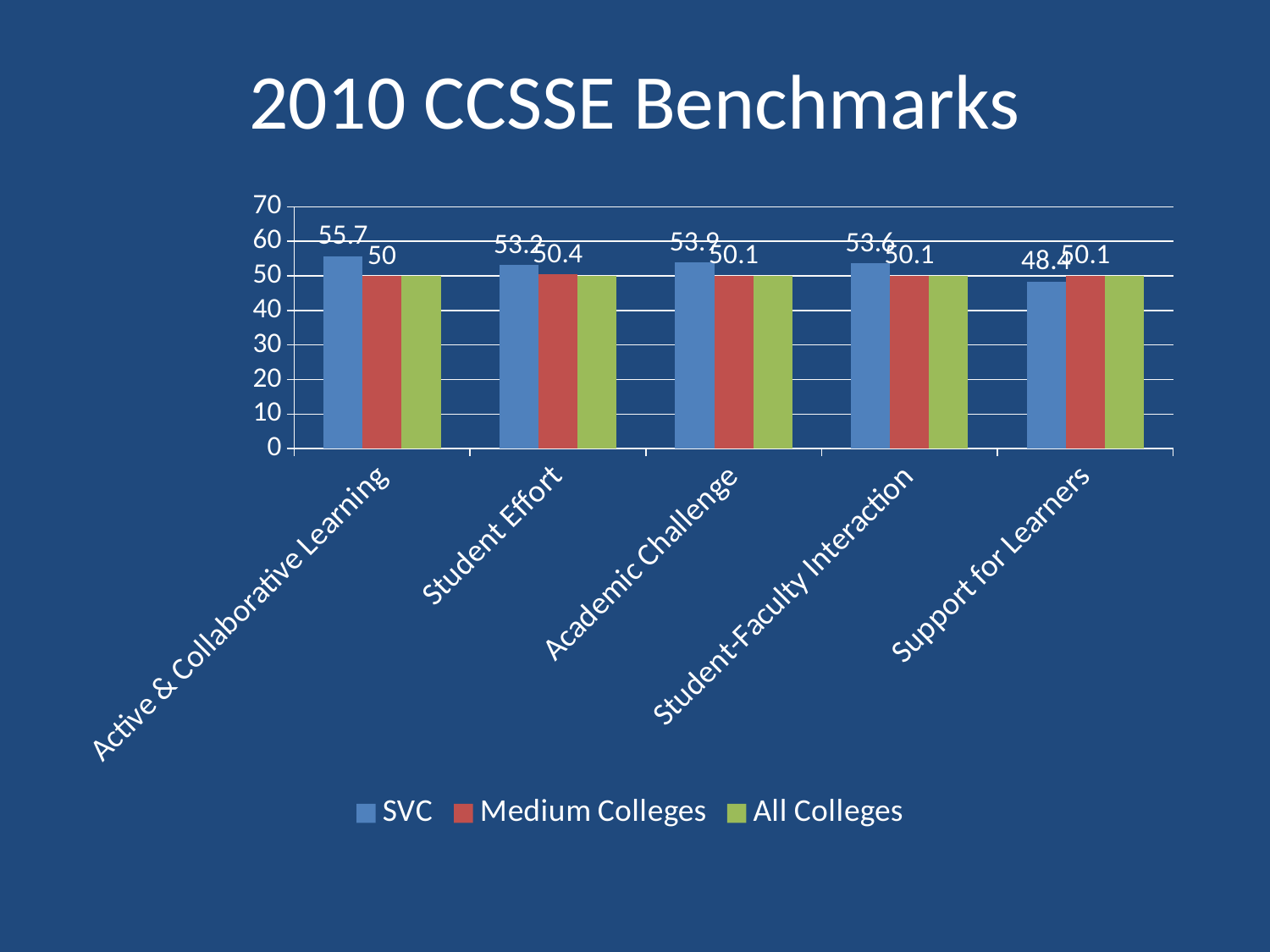
How many benchmark categories are shown on the x axis? 5 Which benchmark has the lowest SVC value? Support for Learners What is the SVC value for Support for Learners? 48.4 What type of chart is shown on the slide? bar chart For Support for Learners, which is larger: the SVC value or the Medium Colleges value? Medium Colleges What is the Medium Colleges value for Active & Collaborative Learning? 50 What is the SVC value for Active & Collaborative Learning? 55.7 Is the All Colleges value for Academic Challenge greater or less than 60? less What is the SVC value for Academic Challenge? 53.9 How many series does the legend list? 3 For Active & Collaborative Learning, how much higher is the SVC value than the Medium Colleges value? 5.7 Which benchmark has the highest SVC value? Active & Collaborative Learning